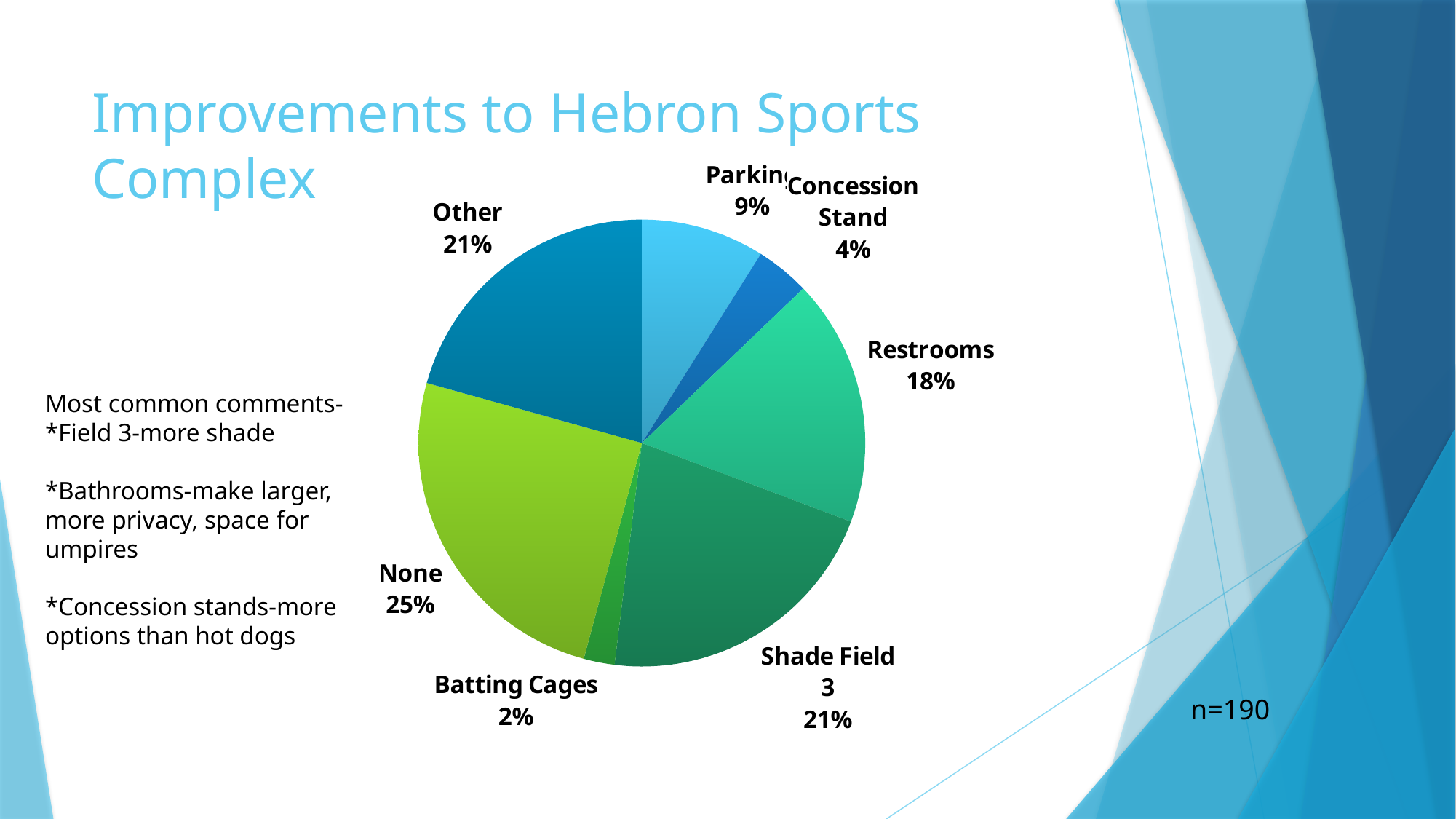
What percentage is shown for Parking? 9% What share of the pie does None account for? 25% What kind of chart is shown on the slide? pie chart What percentage is shown for Restrooms? 18% What is the difference in percentage points between None and Restrooms? 7 Which category has the largest slice of the pie? None Which is larger, the share for Parking or the share for Concession Stand? Parking How many categories are shown in the pie chart? 7 What percentage is shown for Shade Field 3? 21% What percentage is shown for Concession Stand? 4% Which category has the smallest slice of the pie? Batting Cages What is the title of the slide containing the pie chart? Improvements to Hebron Sports Complex